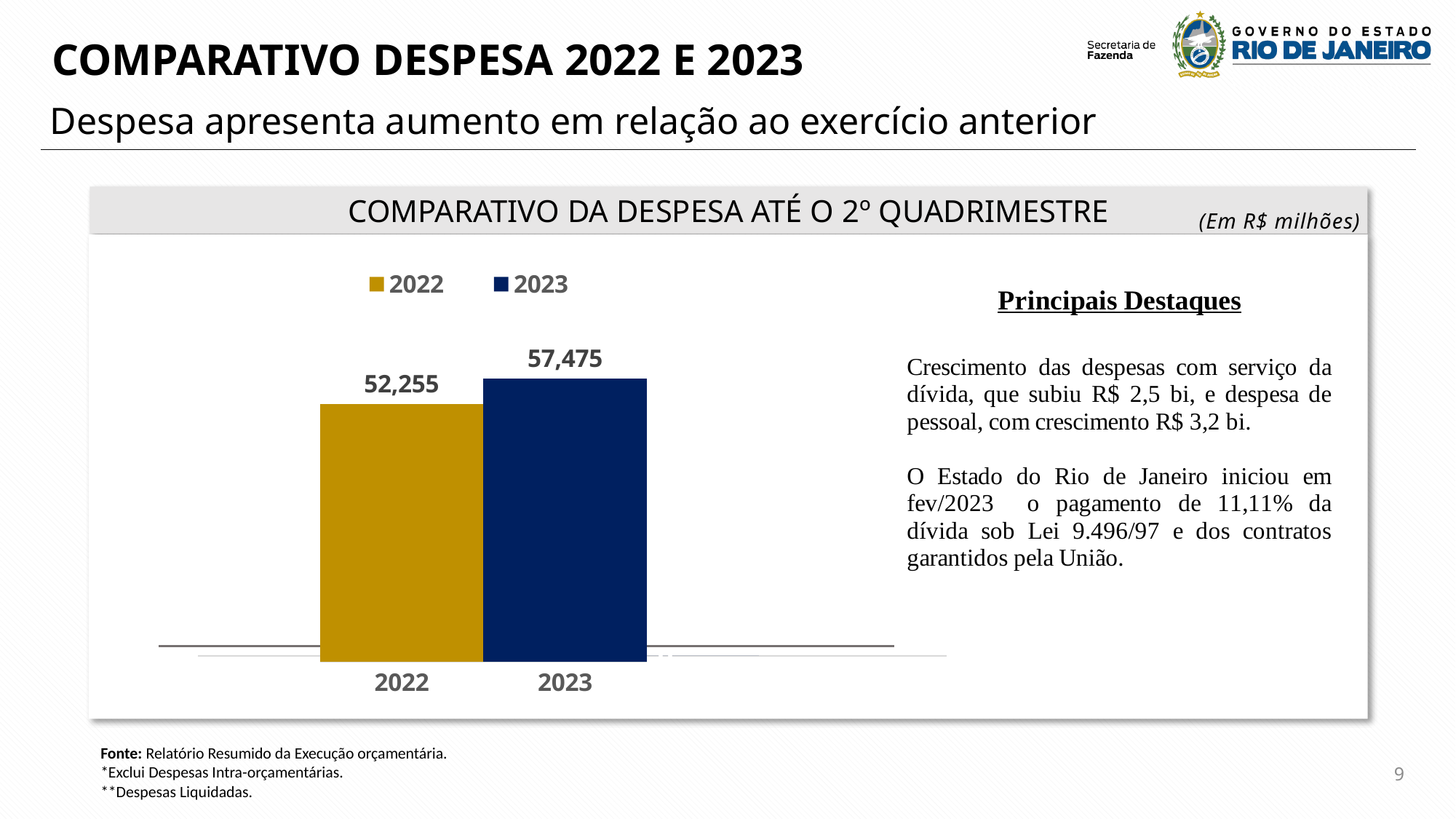
How many bars are plotted in the chart? 2 Do the values rise or fall from 2022 to 2023? Rise Is the value for 2023 larger than the value for 2022? Yes What is the title of the chart? COMPARATIVO DA DESPESA ATÉ O 2º QUADRIMESTRE How many series does the legend list? 2 What kind of chart is shown? Bar chart Which year has the higher value? 2023 What is the value for 2022? 52,255 What is the difference between the 2023 and 2022 values? 5,220 Which year has the lower value? 2022 What is the value for 2023? 57,475 What unit is stated for the chart values? Em R$ milhões